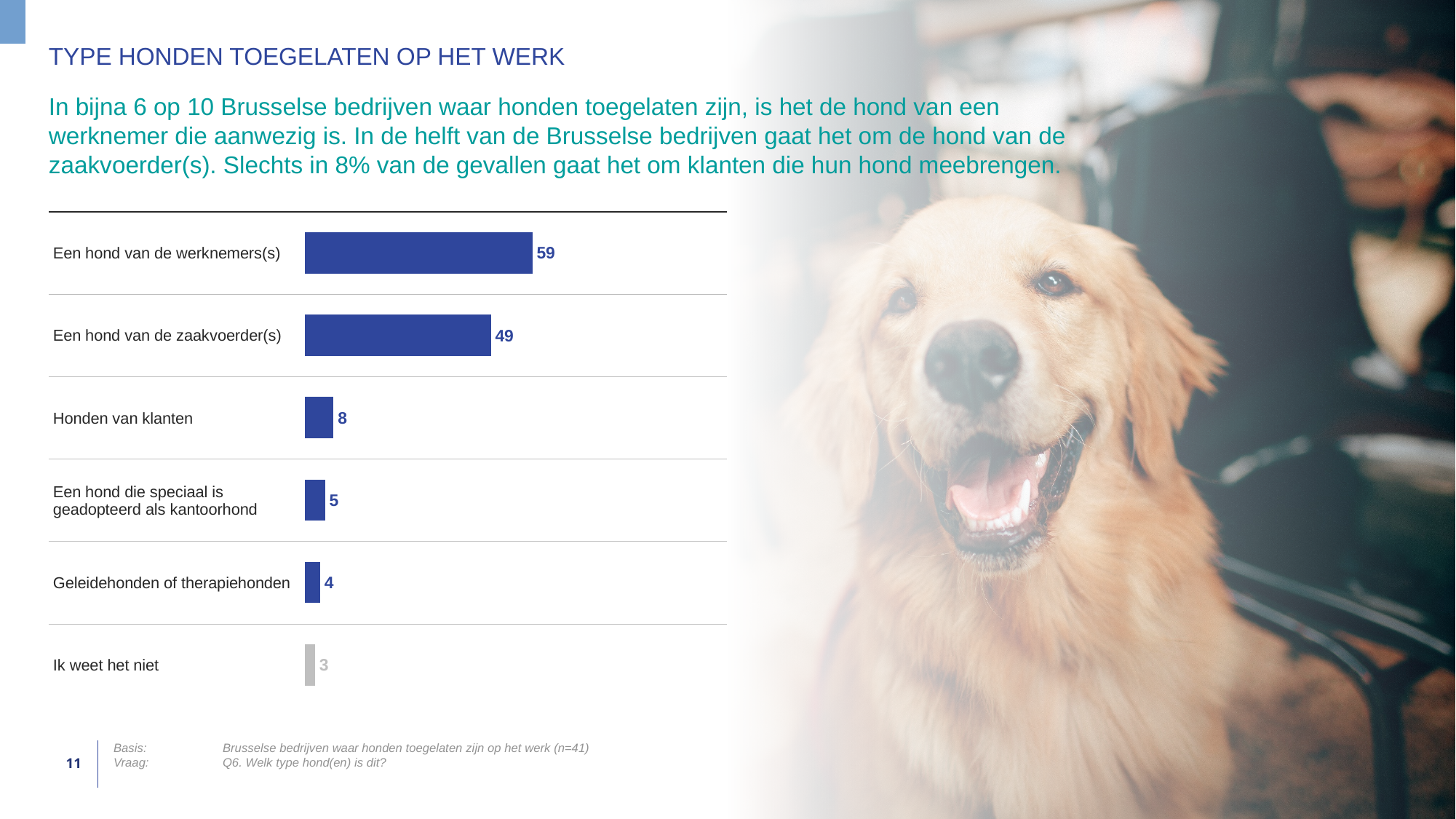
Which is larger: the value for "Honden van klanten" or the value for "Een hond die speciaal is geadopteerd als kantoorhond"? Honden van klanten What is the difference between the values for "Een hond van de werknemers(s)" and "Een hond van de zaakvoerder(s)"? 10 What is the value for "Ik weet het niet"? 3 Which category has the highest value? Een hond van de werknemers(s) What is the value for "Een hond van de werknemers(s)"? 59 What is the value for "Honden van klanten"? 8 Which category has the lowest value? Ik weet het niet Which bar is shown in grey rather than blue? Ik weet het niet What kind of chart is shown on the slide? Bar chart How many categories are shown in the chart? 6 What is the value for "Geleidehonden of therapiehonden"? 4 What is the value for "Een hond van de zaakvoerder(s)"? 49